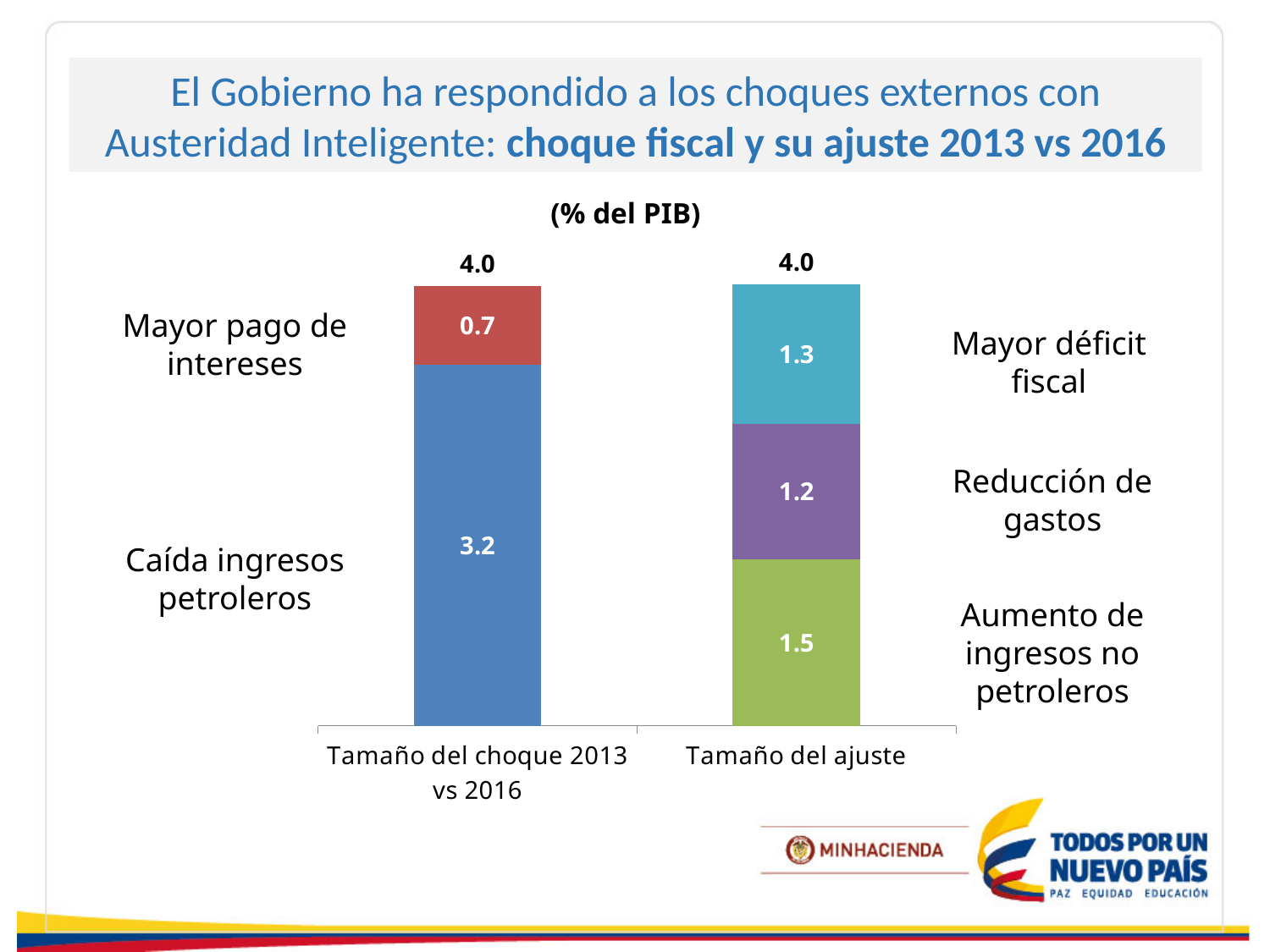
Which segment of the 'Tamaño del ajuste' bar is the largest? Aumento de ingresos no petroleros What is the total shown above the 'Tamaño del ajuste' bar? 4.0 What is the value of the 'Aumento de ingresos no petroleros' segment? 1.5 What is the value of the 'Reducción de gastos' segment? 1.2 Which is larger, the 'Mayor déficit fiscal' segment or the 'Reducción de gastos' segment? Mayor déficit fiscal What is the value of the 'Mayor déficit fiscal' segment in the 'Tamaño del ajuste' bar? 1.3 Which segment of the 'Tamaño del ajuste' bar is the smallest? Reducción de gastos What type of chart is shown on the slide? Stacked bar chart What is the total shown above the 'Tamaño del choque 2013 vs 2016' bar? 4.0 What is the difference between the 'Caída ingresos petroleros' segment and the 'Mayor pago de intereses' segment? 2.5 What is the value of the 'Caída ingresos petroleros' segment in the 'Tamaño del choque 2013 vs 2016' bar? 3.2 What is the value of the 'Mayor pago de intereses' segment? 0.7